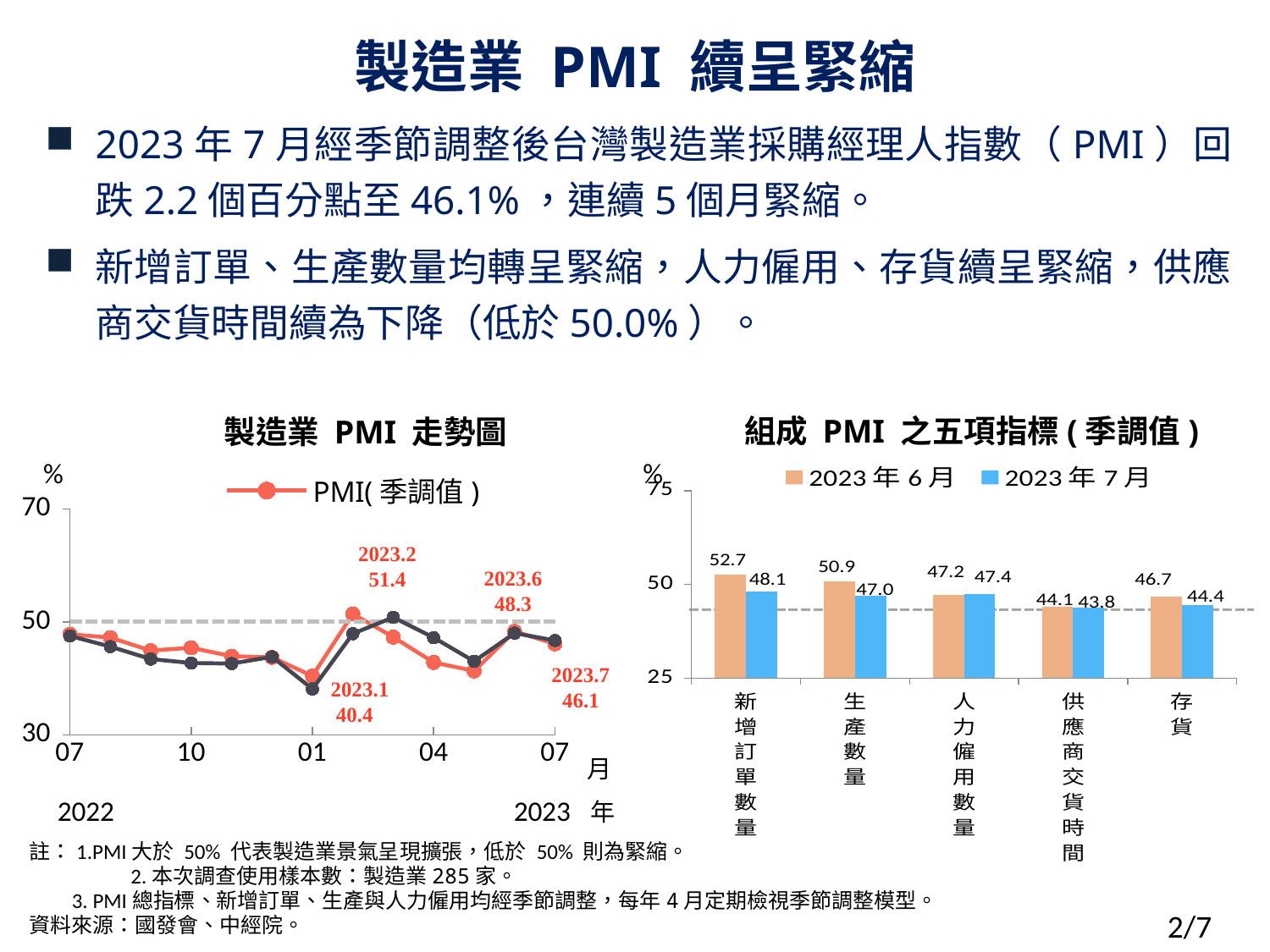
In the chart titled 組成 PMI 之五項指標(季調值), what is the value for 新增訂單數量 in 2023年6月? 52.7 In the chart titled 組成 PMI 之五項指標(季調值), how many categories are shown on the x axis? 5 In the chart titled 組成 PMI 之五項指標(季調值), how many series does the legend list? 2 In the chart titled 組成 PMI 之五項指標(季調值), which category has the highest value for 2023年6月? 新增訂單數量 In the chart titled 製造業 PMI 走勢圖, what is the PMI(季調值) value labelled for 2023.1? 40.4 In the chart titled 製造業 PMI 走勢圖, what is the difference between the labelled values for 2023.2 and 2023.1? 11.0 In the chart titled 組成 PMI 之五項指標(季調值), which category has the lowest value for 2023年7月? 供應商交貨時間 In the chart titled 組成 PMI 之五項指標(季調值), what is the value for 存貨 in 2023年7月? 44.4 In the chart titled 組成 PMI 之五項指標(季調值), what is the difference between the 2023年6月 and 2023年7月 values for 新增訂單數量? 4.6 In the chart titled 組成 PMI 之五項指標(季調值), which is larger for 人力僱用數量: the 2023年6月 value or the 2023年7月 value? 2023年7月 In the chart titled 製造業 PMI 走勢圖, what is the PMI(季調值) value labelled for 2023.7? 46.1 What kind of chart is the one titled 組成 PMI 之五項指標(季調值)? bar chart